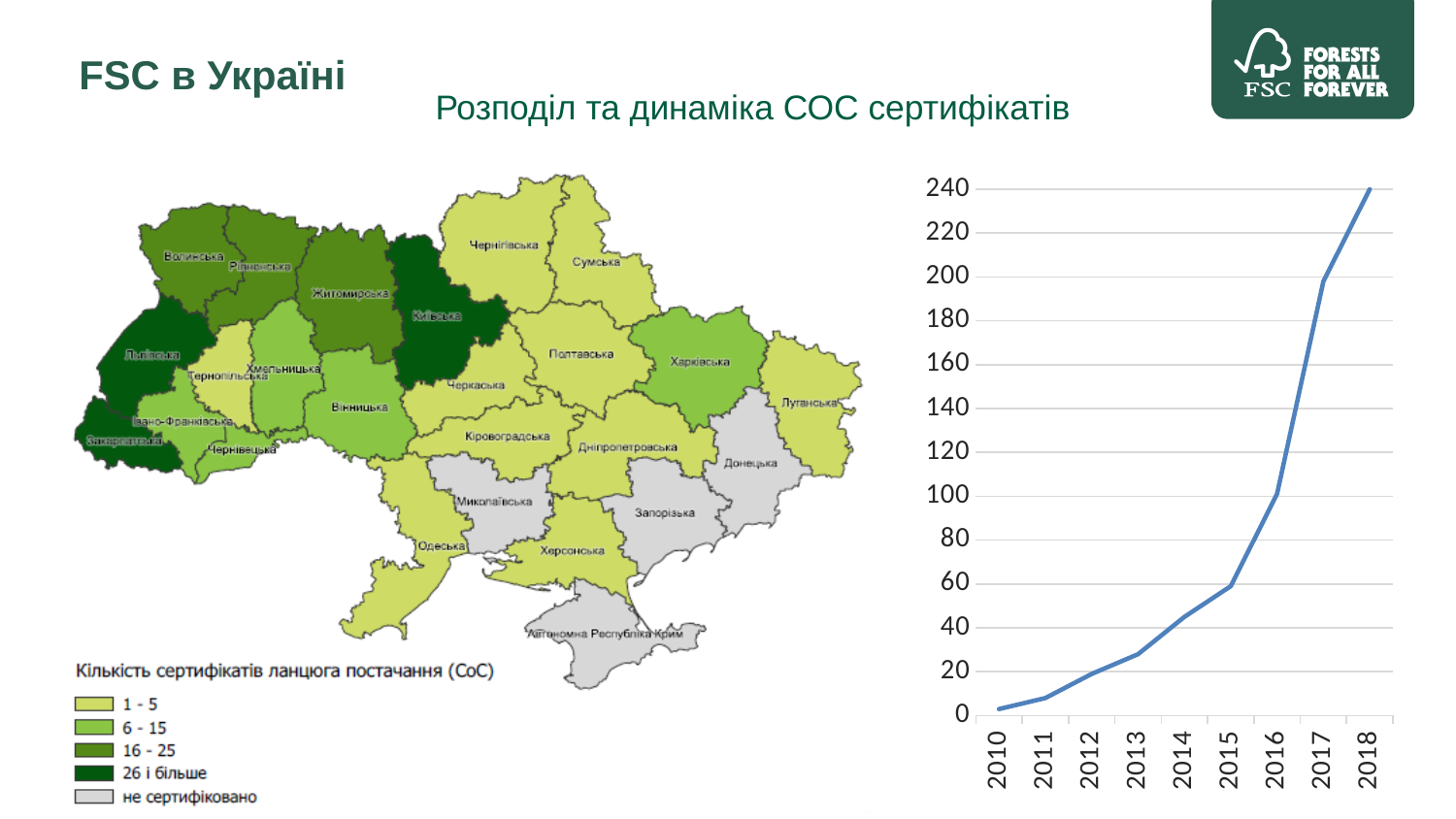
In the line chart on the right, how many years are plotted along the x axis? 9 In the line chart on the right, what is the value for 2018? 240 In the line chart on the right, is the value for 2013 greater or less than 20? greater In the line chart on the right, which year has the larger value, 2016 or 2014? 2016 In the line chart on the right, which year has the highest value? 2018 In the line chart on the right, what is the first year shown on the x axis? 2010 In the line chart on the right, which year has the lowest value? 2010 In the line chart on the right, is the value for 2015 greater or less than 80? less What kind of chart is shown on the right side of the slide? line chart In the map legend on the left, how many categories are listed for the number of CoC certificates? 5 In the line chart on the right, is the value for 2017 greater or less than 180? greater In the line chart on the right, do the values rise or fall from 2010 to 2018? rise